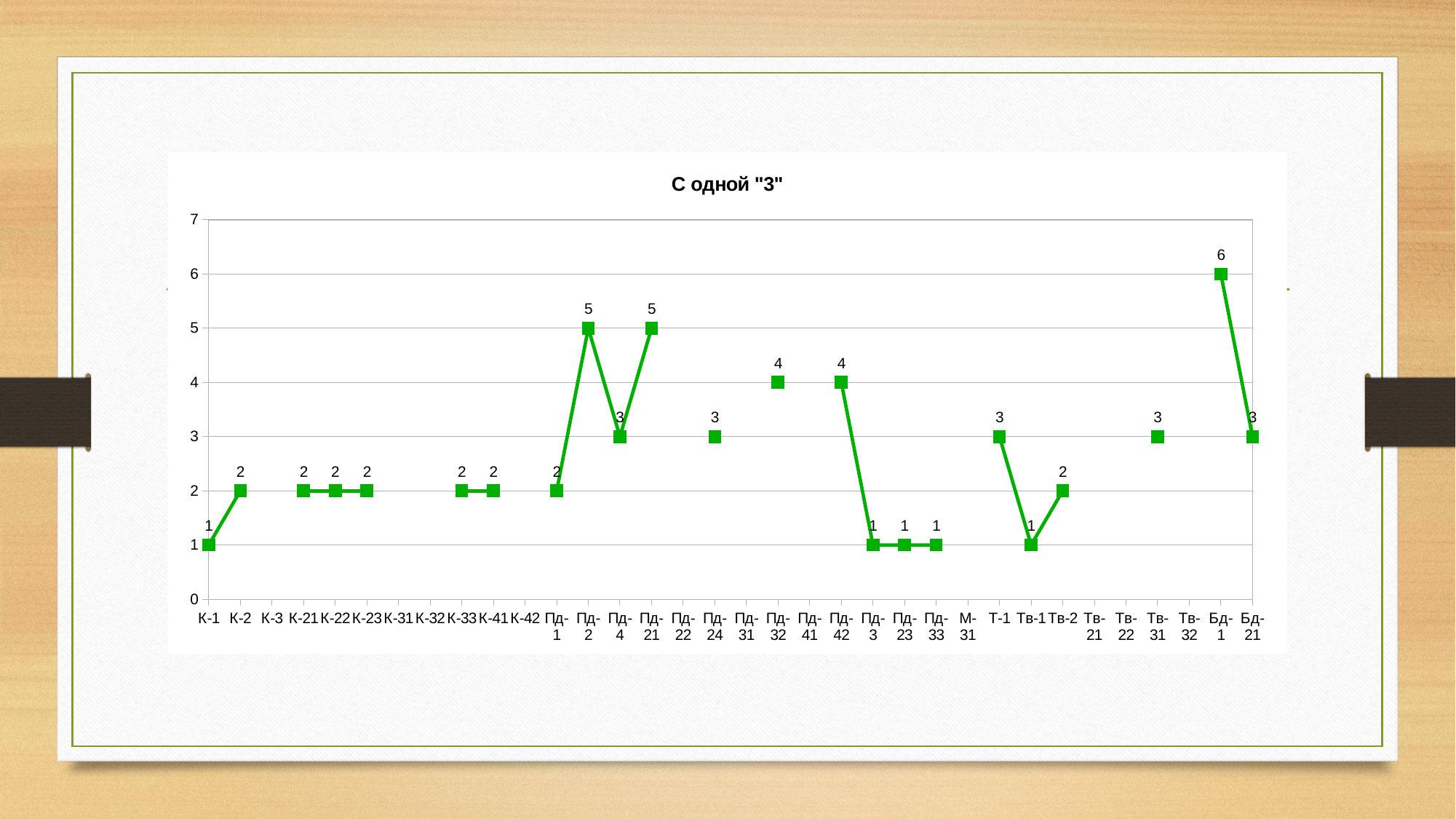
What is the value for Пд-2? 5 What is the value for Пд-32? 4 How many categories are listed on the x axis? 34 What is the title of the chart? С одной "3" What is the value for Тв-1? 1 What type of chart is shown on the slide? line chart What is the difference between the values for Пд-2 and Пд-4? 2 Which category has the highest value? Бд-1 What is the difference between the values for Бд-1 and Бд-21? 3 Which is larger, the value for Т-1 or the value for Тв-2? Т-1 What is the value for Бд-1? 6 Which is larger, the value for Пд-42 or the value for Пд-3? Пд-42